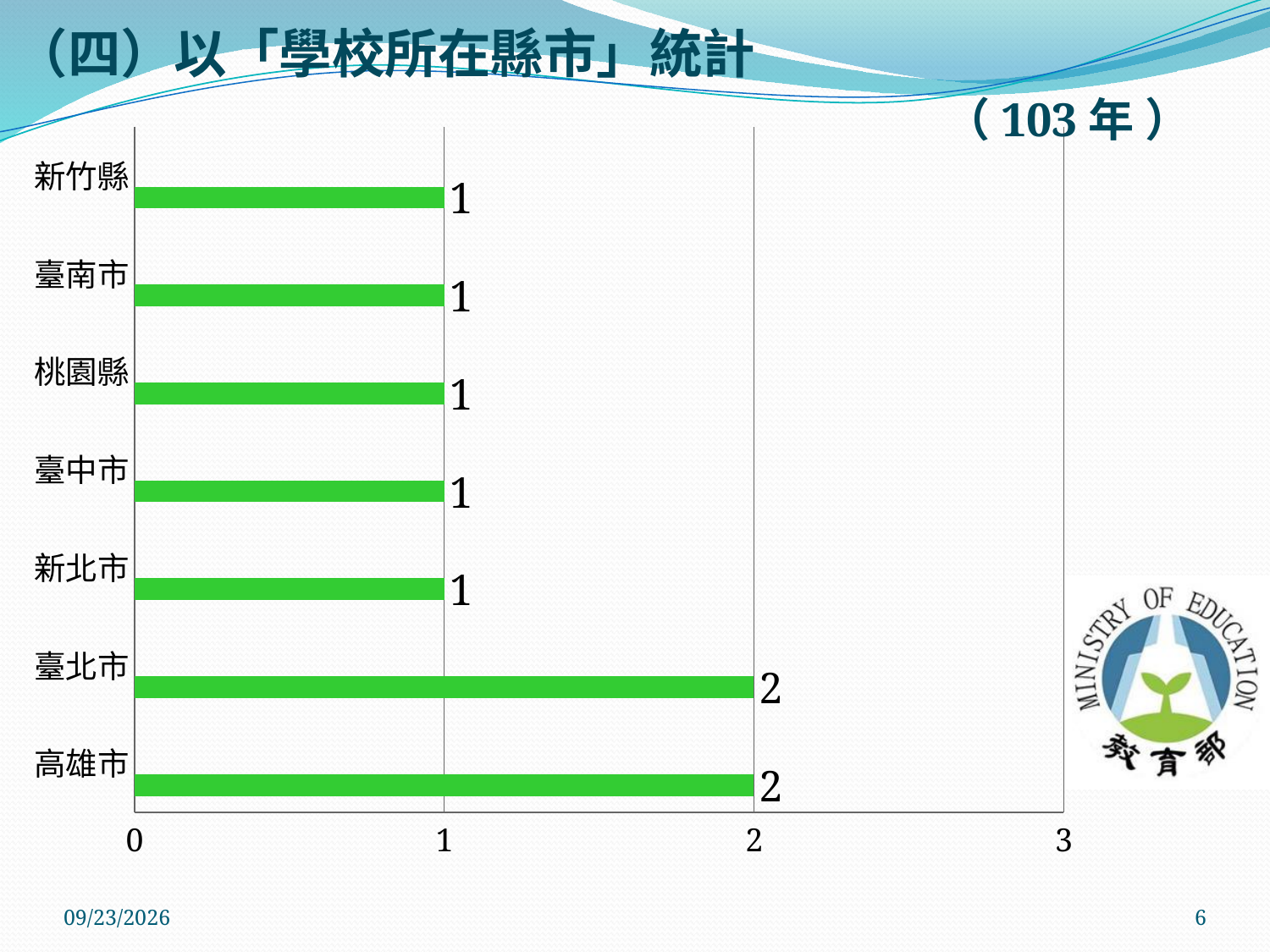
What is the value for 高雄市? 2 What kind of chart is shown on the slide? Bar chart What is the highest value shown in the chart? 2 What is the value for 臺北市? 2 What is the value for 新北市? 1 What is the maximum value shown on the horizontal axis of the chart? 3 What is the value for 臺中市? 1 What is the value for 新竹縣? 1 Which is larger, the value for 高雄市 or the value for 臺南市? 高雄市 How many categories are shown in the chart? 7 Which two categories share the highest value in the chart? 臺北市 and 高雄市 What is the difference between the values for 臺北市 and 桃園縣? 1